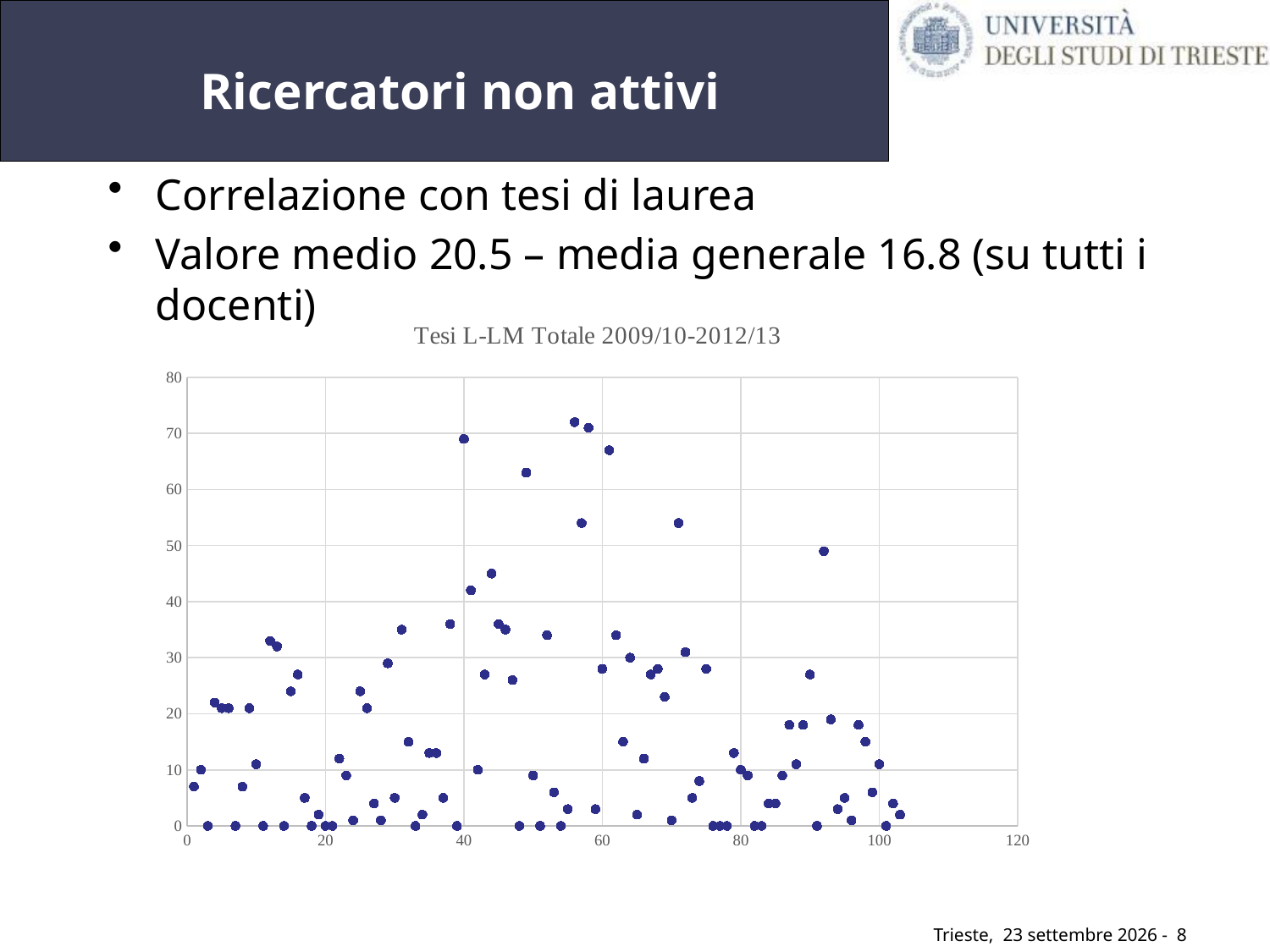
What is the maximum value shown on the chart's vertical axis? 80 Is the largest horizontal-axis value among the plotted points greater or less than 110? less Is the vertical-axis value of the highest plotted point greater or less than 60? greater What is the title of the chart? Tesi L-LM Totale 2009/10-2012/13 What kind of chart is shown on the slide? scatter chart Is the horizontal-axis position of the highest plotted point greater or less than 40? greater